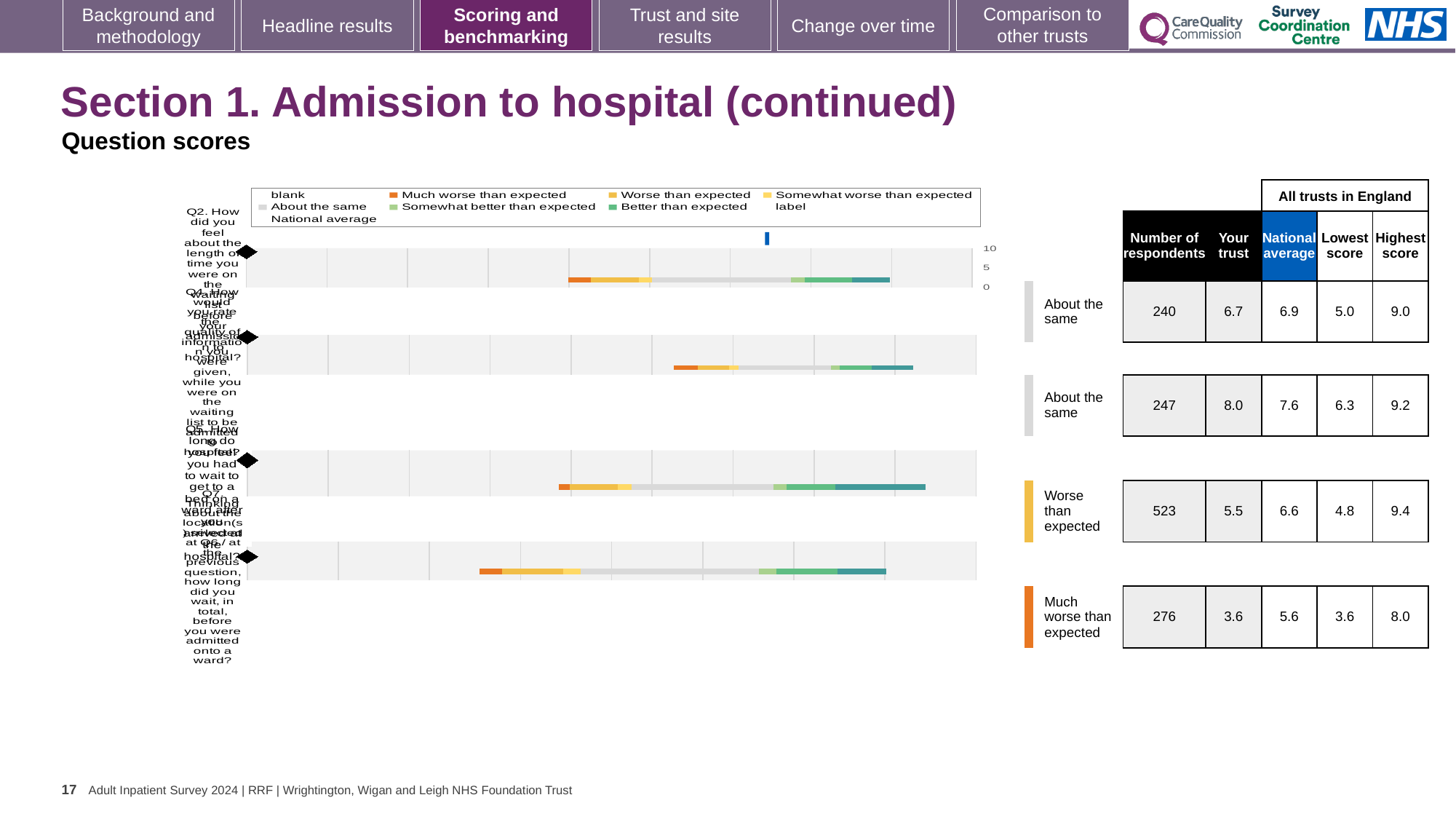
In the table on the right, which row has the highest number of respondents? The third row (523) In the table on the right, what is the number of respondents in the first row? 240 In the table on the right, what is the difference between the highest score and the lowest score in the second row? 2.9 In the chart legend, what colour represents 'Much worse than expected'? Orange In the table on the right, what is the lowest score in the fourth row? 3.6 In the table on the right, is the 'Your trust' score in the first row larger or smaller than the national average in that row? Smaller In the table on the right, what is the 'Your trust' score in the second row? 8.0 In the table on the right, which row has the lowest 'Your trust' score? The fourth row (3.6) In the table on the right, what is the national average in the third row? 6.6 In the table on the right, what rating label is shown next to the fourth row? Much worse than expected What is the maximum value shown on the chart's score axis? 10 How many rows of scores does the table on the right contain? 4